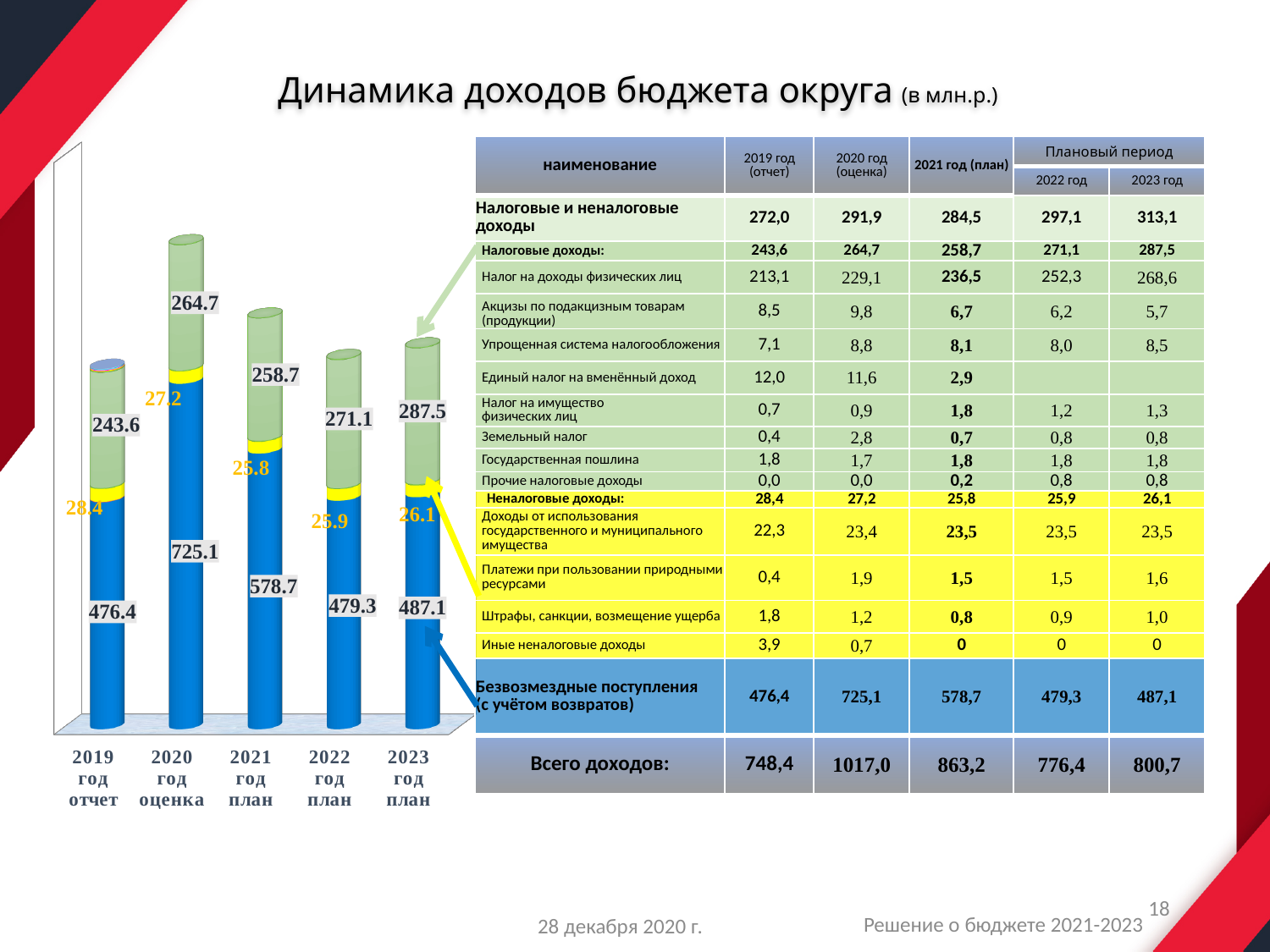
In the bar chart, which year has the tallest blue (bottom) segment? 2020 год оценка In the bar chart, what is the value of the yellow (middle) segment for 2021 год план? 25.8 What is the title of the slide's chart and table? Динамика доходов бюджета округа (в млн.р.) In the bar chart, what is the difference between the blue segment values for 2020 год оценка and 2019 год отчет? 248.7 In the bar chart, is the green segment larger for 2022 год план or for 2021 год план? 2022 год план In the bar chart, which year has the smallest green (top) segment? 2019 год отчет In the bar chart, what is the total of the stacked bar for 2019 год отчет? 748.4 In the bar chart, what is the value of the green (top) segment for 2023 год план? 287.5 In the bar chart, what is the value of the blue (bottom) segment for 2020 год оценка? 725.1 What kind of chart is shown on the left of the slide? bar chart In the bar chart, what is the total of the stacked bar for 2023 год план? 800.7 How many year categories are shown along the x axis of the bar chart? 5